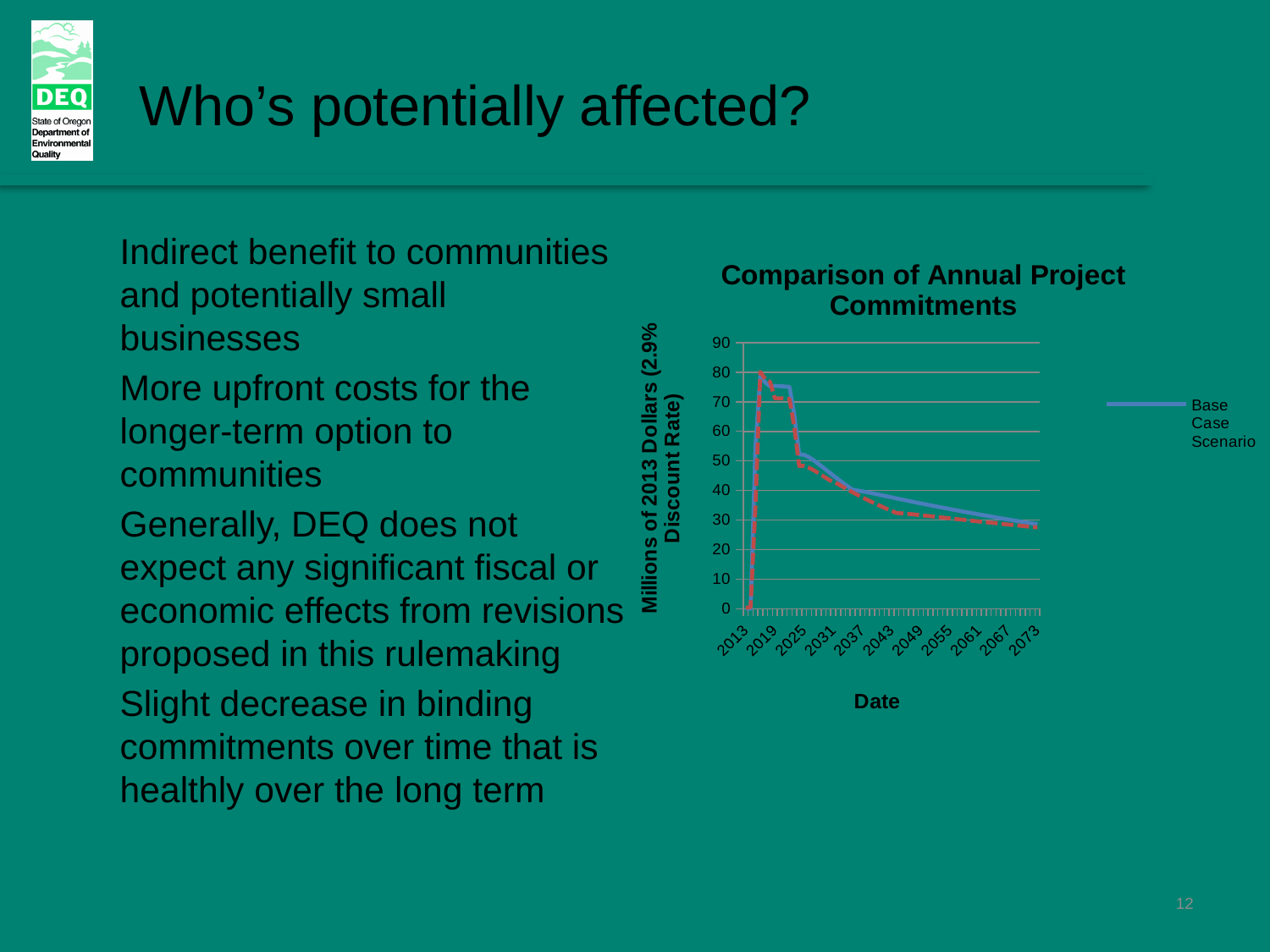
From 2025 to 2073, do the values of the Base Case Scenario line rise or fall? fall How many year labels are shown along the x axis of the chart? 11 How many series does the chart's legend list? 1 Is the value of the Base Case Scenario line at 2049 greater or less than 40? less Is the value of the Base Case Scenario line at 2049 greater or less than 30? greater Is the value of the Base Case Scenario line at 2073 greater or less than 40? less At 2043, which line is higher: the solid Base Case Scenario line or the dashed line? the solid Base Case Scenario line What is the label of the vertical axis of the chart? Millions of 2013 Dollars (2.9% Discount Rate) What is the title of the chart? Comparison of Annual Project Commitments What kind of chart is shown on the slide? line chart What is the highest value shown on the vertical axis of the chart? 90